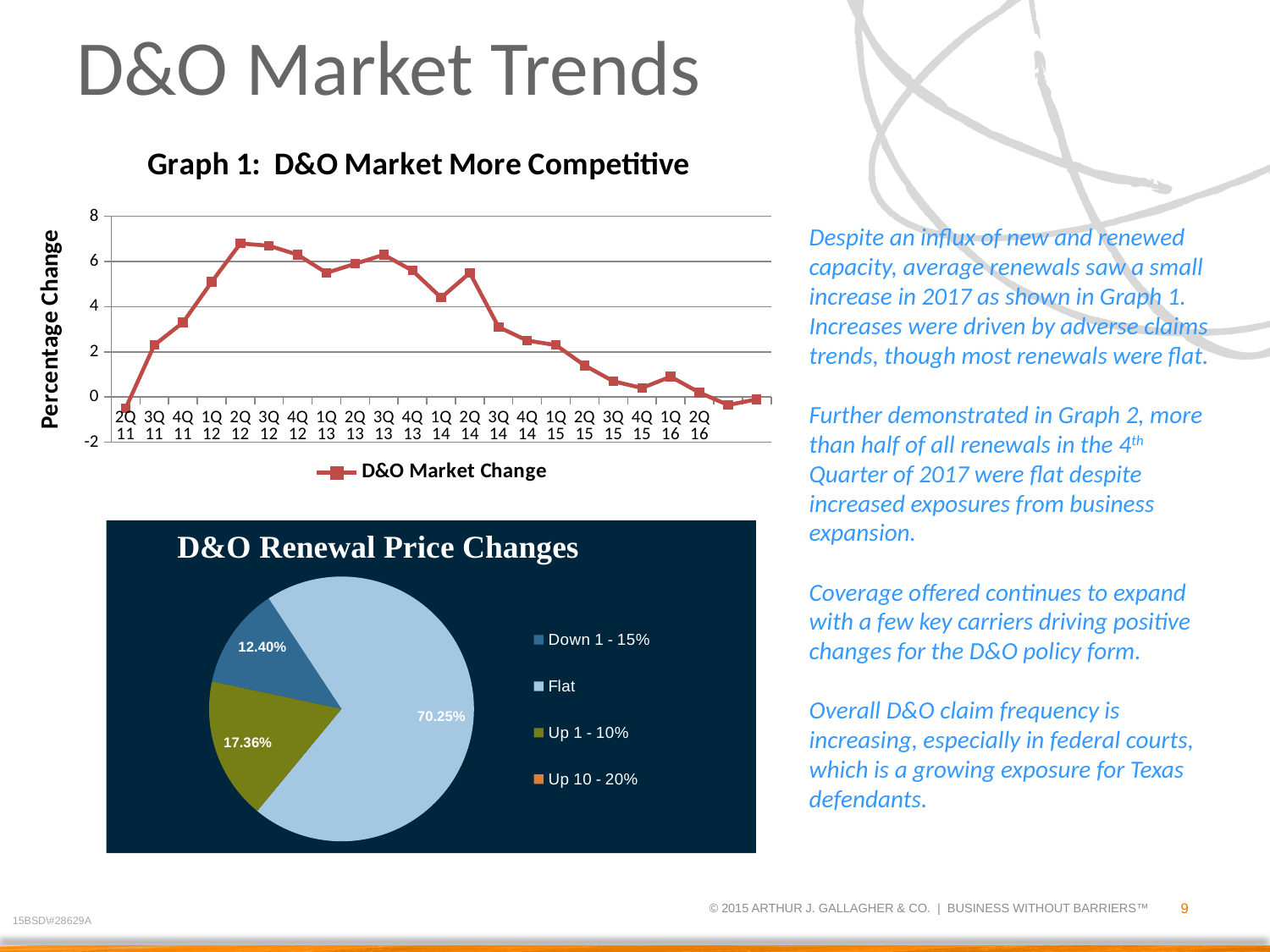
In Graph 1: D&O Market More Competitive, is the value for 2Q 15 greater or less than 2? less In D&O Renewal Price Changes, what is the value for Up 1 - 10%? 17.36% In Graph 1: D&O Market More Competitive, how many series does the legend list? 1 In Graph 1: D&O Market More Competitive, is the value for 1Q 12 greater or less than 4? greater What kind of chart is Graph 1: D&O Market More Competitive? Line chart In D&O Renewal Price Changes, what share of the pie is Flat? 70.25% In Graph 1: D&O Market More Competitive, is the value for 2Q 12 greater or less than 6? greater In D&O Renewal Price Changes, how many entries does the legend list? 4 In Graph 1: D&O Market More Competitive, which is larger, the value for 2Q 12 or the value for 1Q 14? 2Q 12 In Graph 1: D&O Market More Competitive, do the values generally rise or fall from 2Q 12 to 2Q 16? Fall What kind of chart is D&O Renewal Price Changes? Pie chart In Graph 1: D&O Market More Competitive, what is the name of the series shown in the legend? D&O Market Change